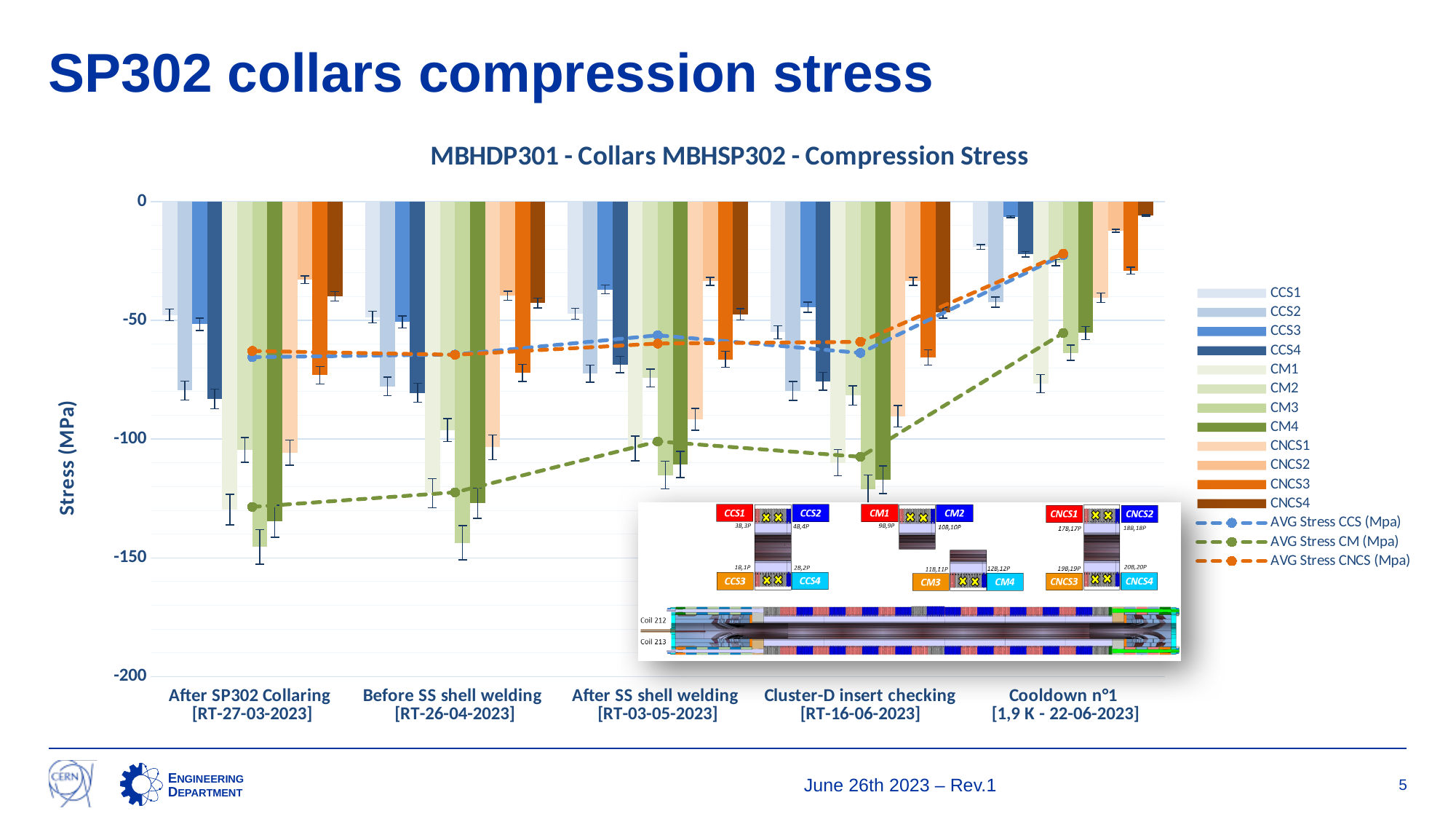
Is the AVG Stress CM (Mpa) value at 'After SP302 Collaring' greater or less than -100? less What is the label of the vertical axis? Stress (MPa) In which category does the AVG Stress CM (Mpa) line reach its highest (least negative) value? Cooldown n°1 [1,9 K - 22-06-2023] How many categories are shown along the x axis of the chart? 5 What is the title of the chart? MBHDP301 - Collars MBHSP302 - Compression Stress Is the CM2 bar at 'After SP302 Collaring' greater or less than -100? less Does the AVG Stress CM (Mpa) line rise or fall from left to right across the categories? rise Is the AVG Stress CM (Mpa) value at 'Cooldown n°1' greater or less than -100? greater At 'After SP302 Collaring', which bar extends further below zero: CCS1 or CM2? CM2 What kind of chart is shown on the slide? Bar chart with line series How many series does the chart legend list? 15